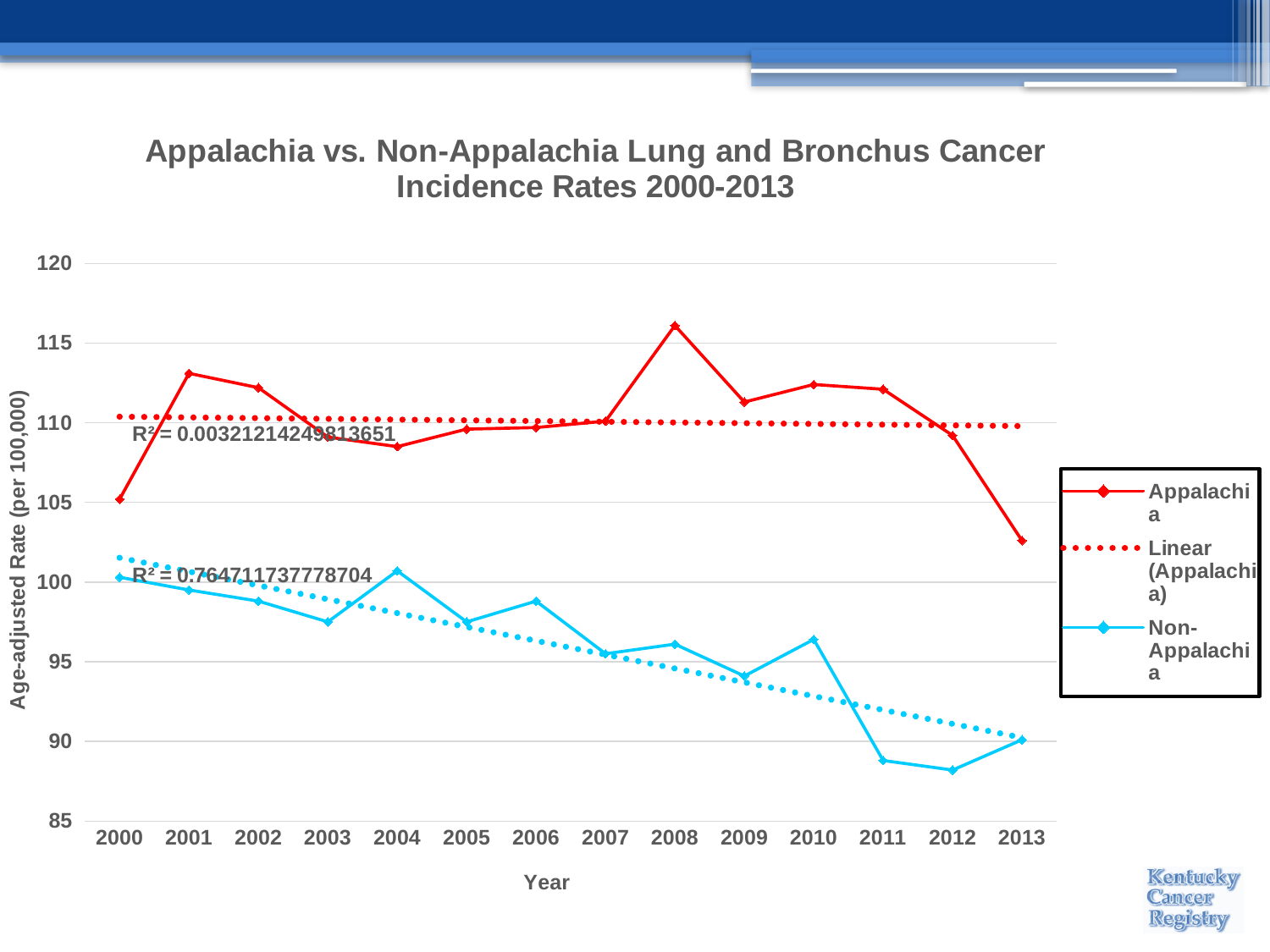
Is the Non-Appalachia value for 2009 greater or less than 95? less In which year is the Appalachia incidence rate lowest? 2013 How many years are plotted along the x axis? 14 Does the Non-Appalachia incidence rate generally rise or fall from 2000 to 2013? fall Is the Appalachia value for 2013 greater or less than 105? less How many series does the legend list? 3 Is the Non-Appalachia value for 2011 greater or less than 90? less What kind of chart is shown on the slide? line chart Which series has the larger value in 2008, Appalachia or Non-Appalachia? Appalachia What R² value is shown for the Non-Appalachia trendline? 0.764711737778704 In which year is the Appalachia incidence rate highest? 2008